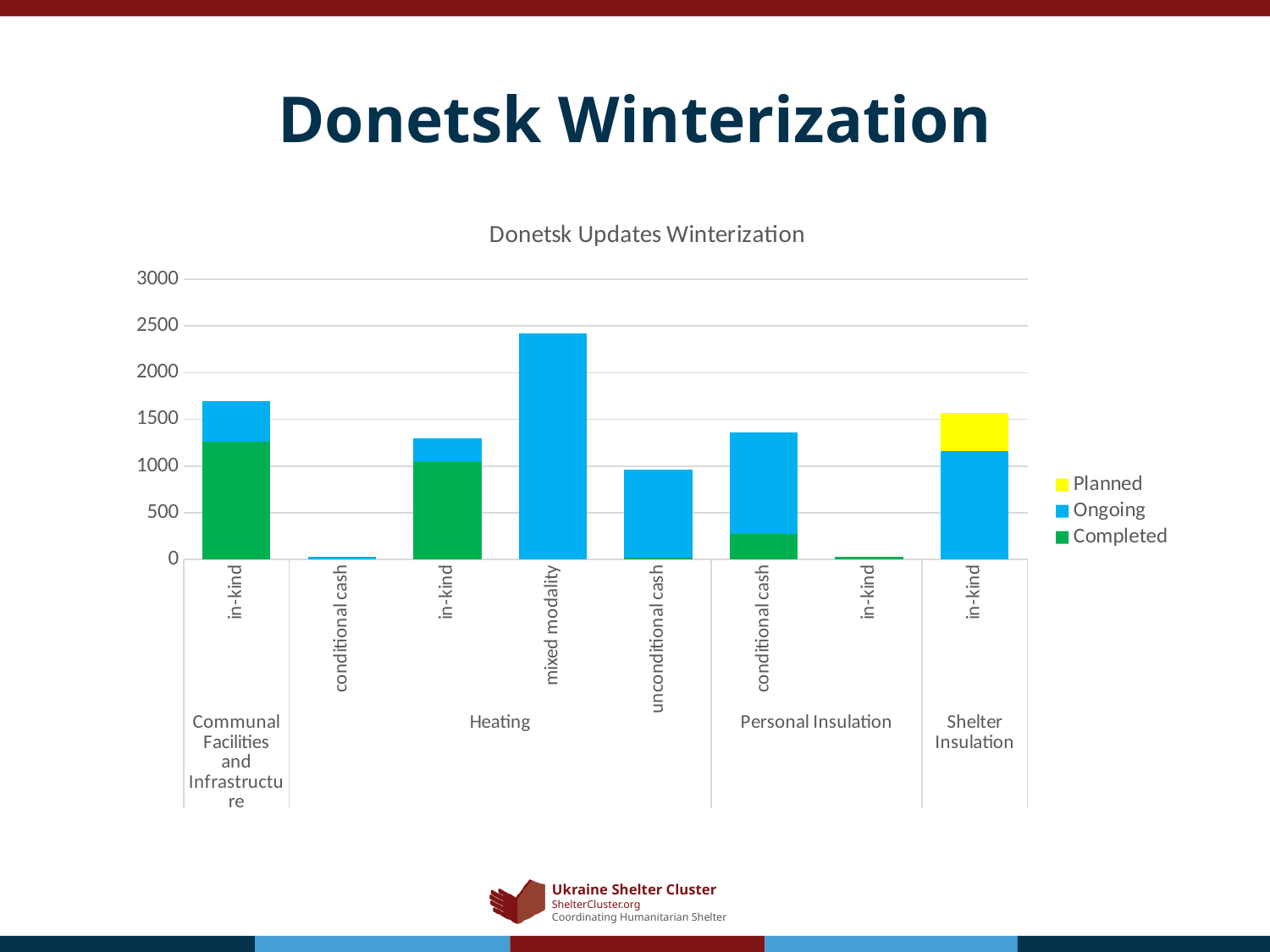
How many series does the legend list? 3 Which is larger: the total for Heating mixed modality or the total for Personal Insulation conditional cash? Heating mixed modality What is the title of the chart? Donetsk Updates Winterization Is the total value for the Heating mixed modality bar greater or less than 2000? greater Which is larger: the total for Communal Facilities and Infrastructure in-kind or the total for Heating in-kind? Communal Facilities and Infrastructure in-kind How many bars are plotted in the chart? 8 Which bar is the only one with a Planned (yellow) segment? Shelter Insulation, in-kind Is the total value for the Personal Insulation conditional cash bar greater or less than 1000? greater What kind of chart is shown on the slide? bar chart Which bar is the tallest in the chart? Heating, mixed modality Is the total value for the Communal Facilities and Infrastructure in-kind bar greater or less than 1500? greater